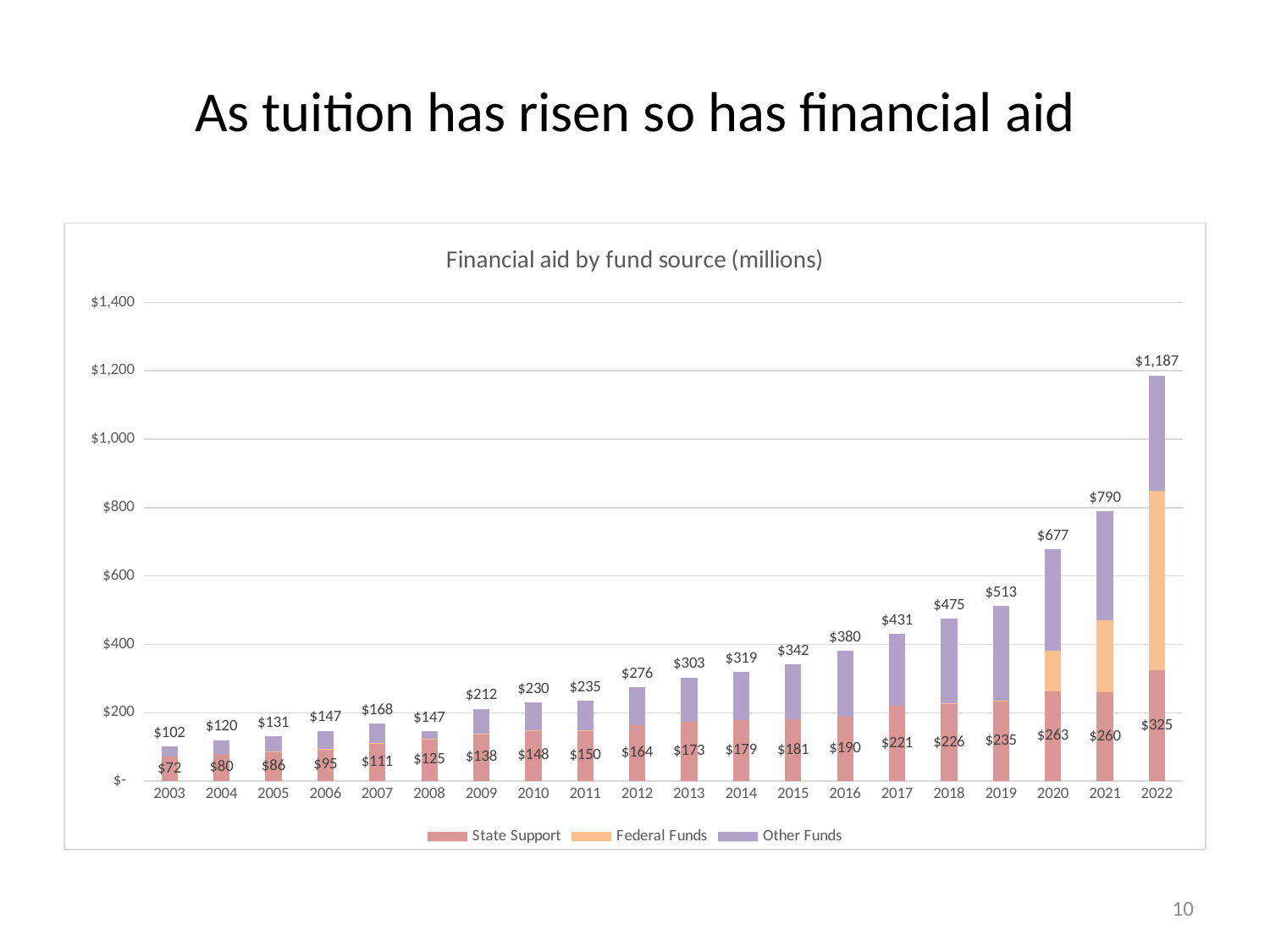
Which year has the highest total financial aid? 2022 How many years are shown on the x axis? 20 What kind of chart is shown on the slide? Stacked bar chart Do the total financial aid values rise or fall from 2003 to 2022? Rise What is the total financial aid shown for 2022? $1,187 What is the State Support value for 2003? $72 Which year has the larger total financial aid, 2015 or 2016? 2016 What is the total financial aid shown for 2010? $230 What is the difference between the total financial aid in 2022 and in 2021? $397 How many series does the legend list? 3 What is the State Support value for 2022? $325 Which year has the lowest total financial aid? 2003